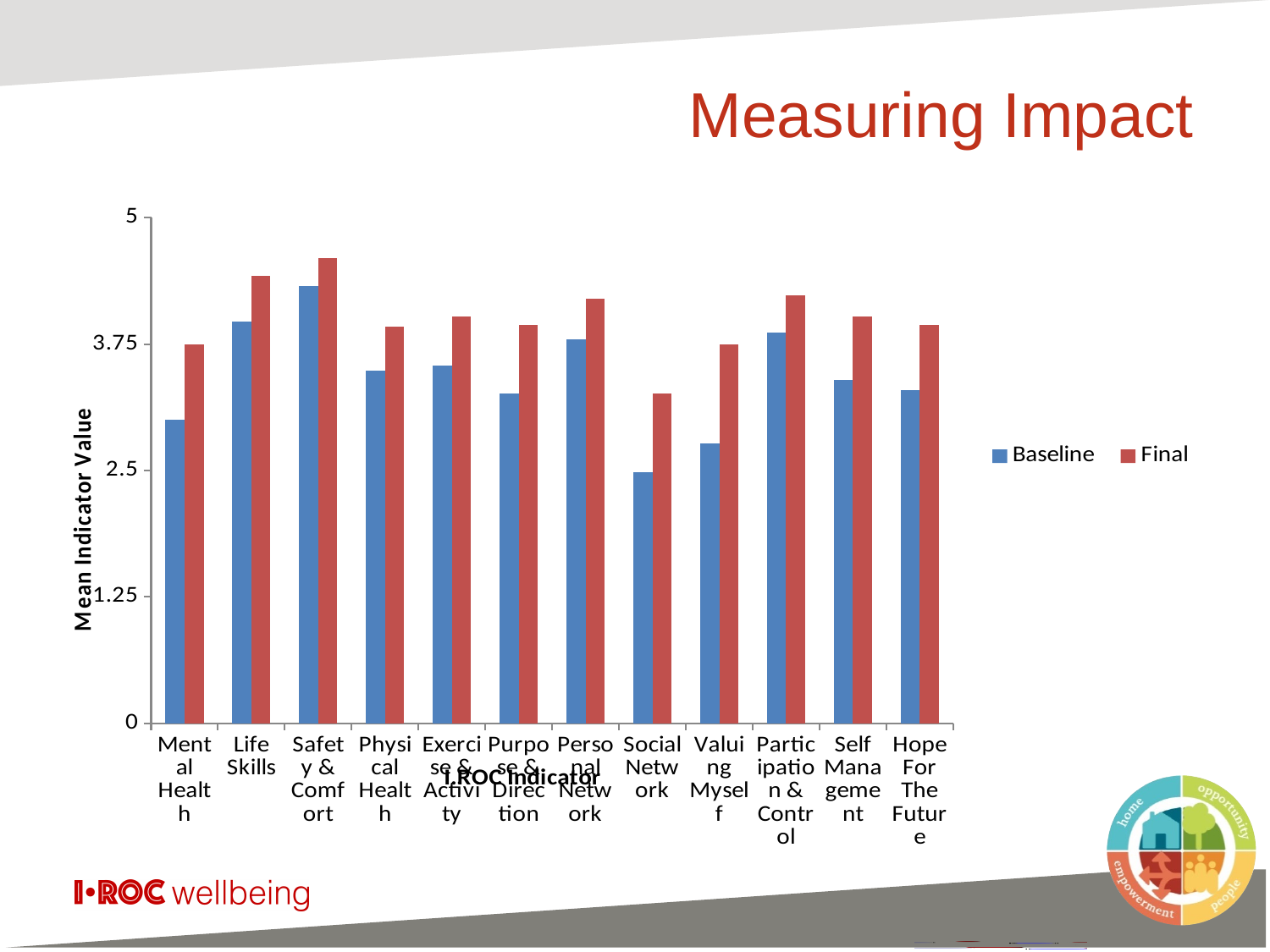
Which category has the highest Final value? Safety & Comfort Which category has the highest Baseline value? Safety & Comfort What kind of chart is shown on the slide? bar chart How many series does the legend list? 2 How many I.ROC indicator categories are plotted on the x axis? 12 Which category has the lowest Baseline value? Social Network For Mental Health, which is larger: the Baseline value or the Final value? Final Is the Final value for Social Network greater or less than 3.75? less Which category has the lowest Final value? Social Network Is the Baseline value for Mental Health greater or less than 3.75? less Is the Final value for Safety & Comfort greater or less than 3.75? greater What is the title of the y axis? Mean Indicator Value